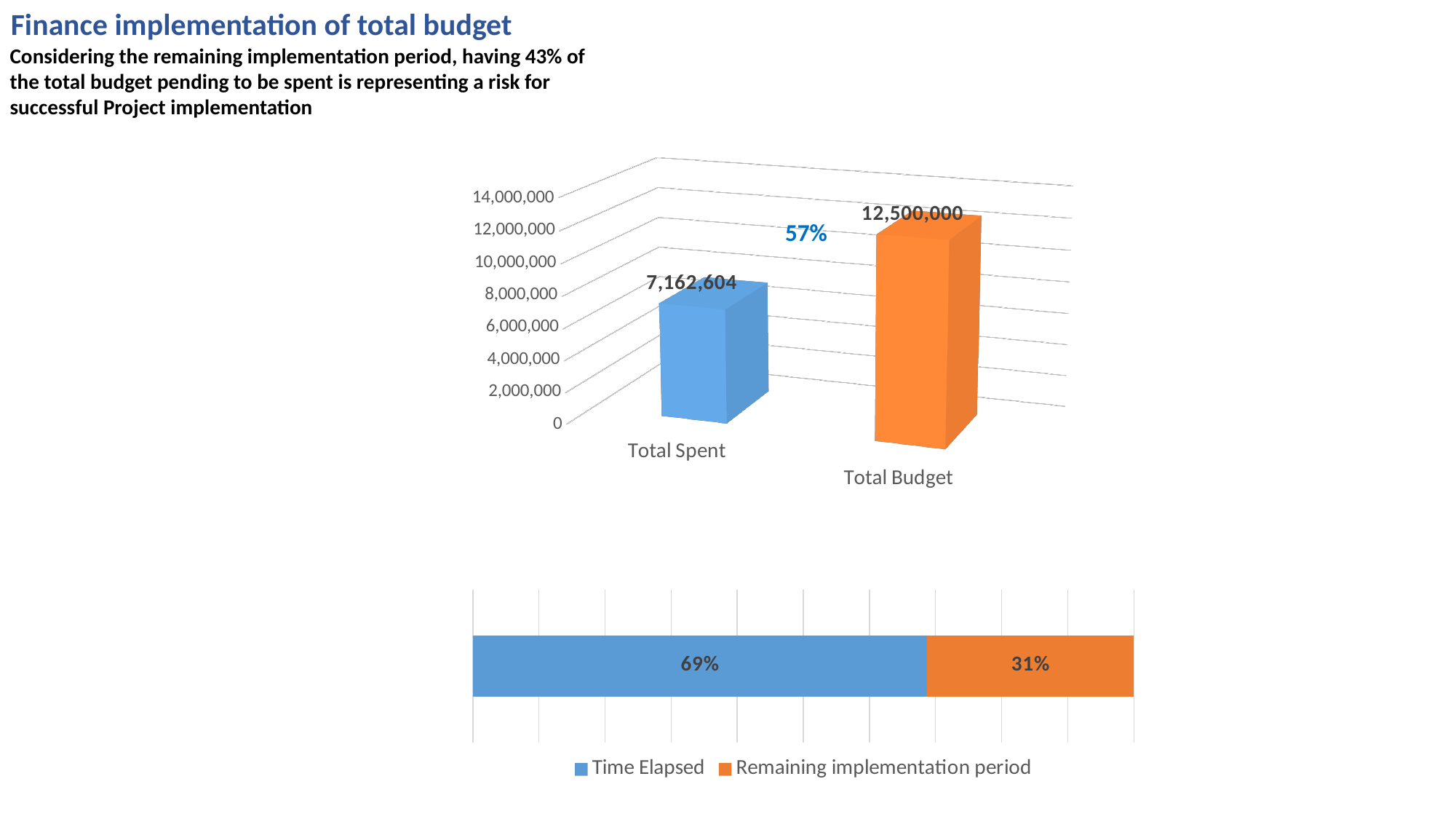
In the bottom chart, what is the value for Time Elapsed? 69% In the top chart, what percentage is printed between the two bars? 57% In the bottom chart, what is the total of the stacked bar? 100% In the top chart, what is the value for Total Budget? 12,500,000 In the top chart, what is the difference between Total Budget and Total Spent? 5,337,396 In the bottom chart, which series is larger, Time Elapsed or Remaining implementation period? Time Elapsed What kind of chart is the top chart? bar chart In the top chart, how many categories are shown? 2 In the top chart, which category has the higher value, Total Spent or Total Budget? Total Budget In the bottom chart, what is the value for Remaining implementation period? 31% In the bottom chart, how many series does the legend list? 2 In the top chart, what is the value for Total Spent? 7,162,604